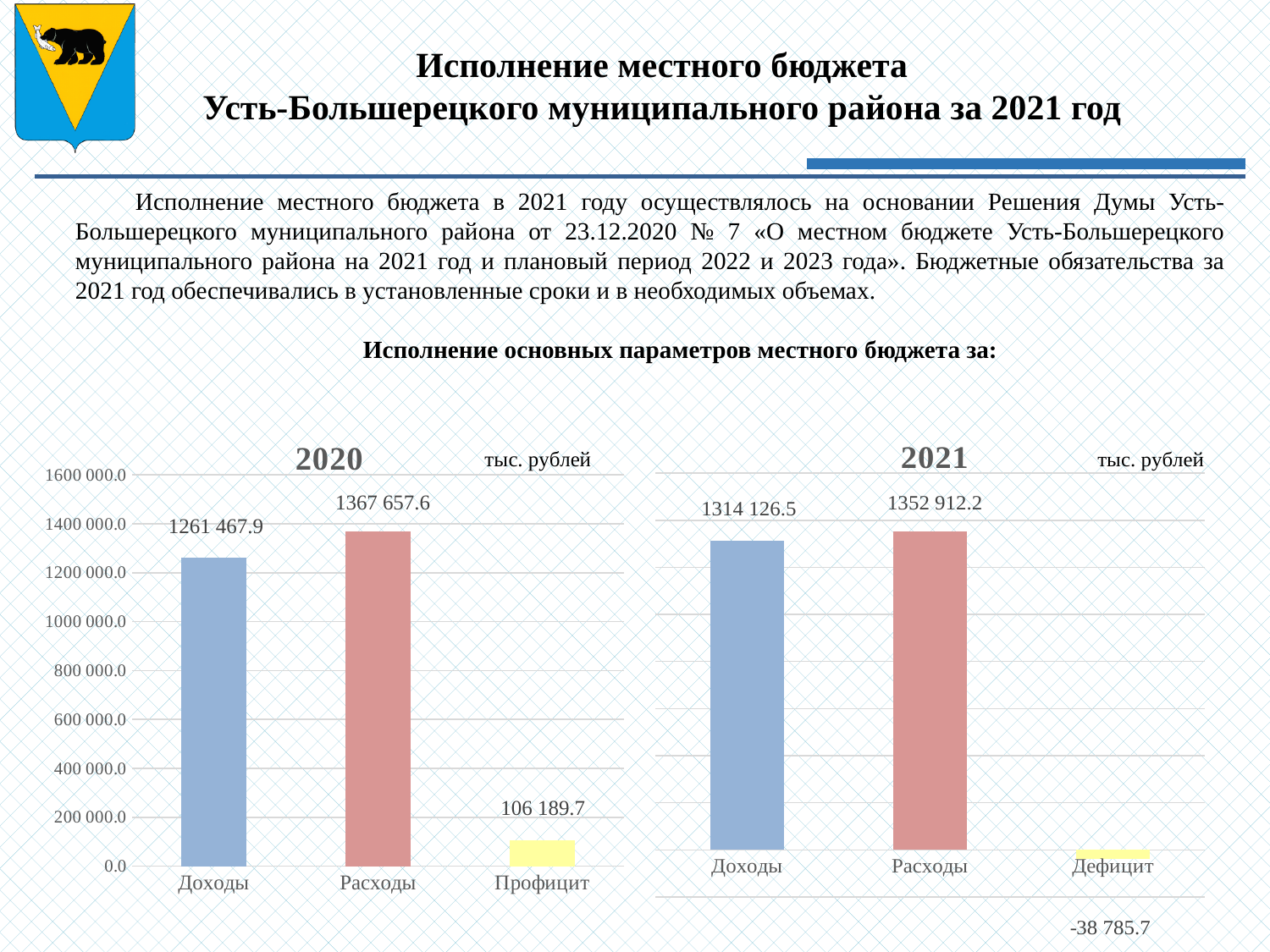
In the 2020 chart, what is the value for Доходы? 1261 467.9 In the 2020 chart, what is the difference between Расходы and Доходы? 106 189.7 In the 2021 chart, what is the value for Дефицит? -38 785.7 In the 2020 chart, what is the value for Расходы? 1367 657.6 In the 2021 chart, what is the value for Доходы? 1314 126.5 In the 2020 chart, what is the value for Профицит? 106 189.7 In the 2021 chart, which category has the lowest value? Дефицит In the 2020 chart, which category has the highest value? Расходы In the 2021 chart, which is larger, Доходы or Расходы? Расходы In the 2021 chart, what is the value for Расходы? 1352 912.2 How many categories does the 2021 chart show? 3 What kind of chart is the 2020 chart? Bar chart